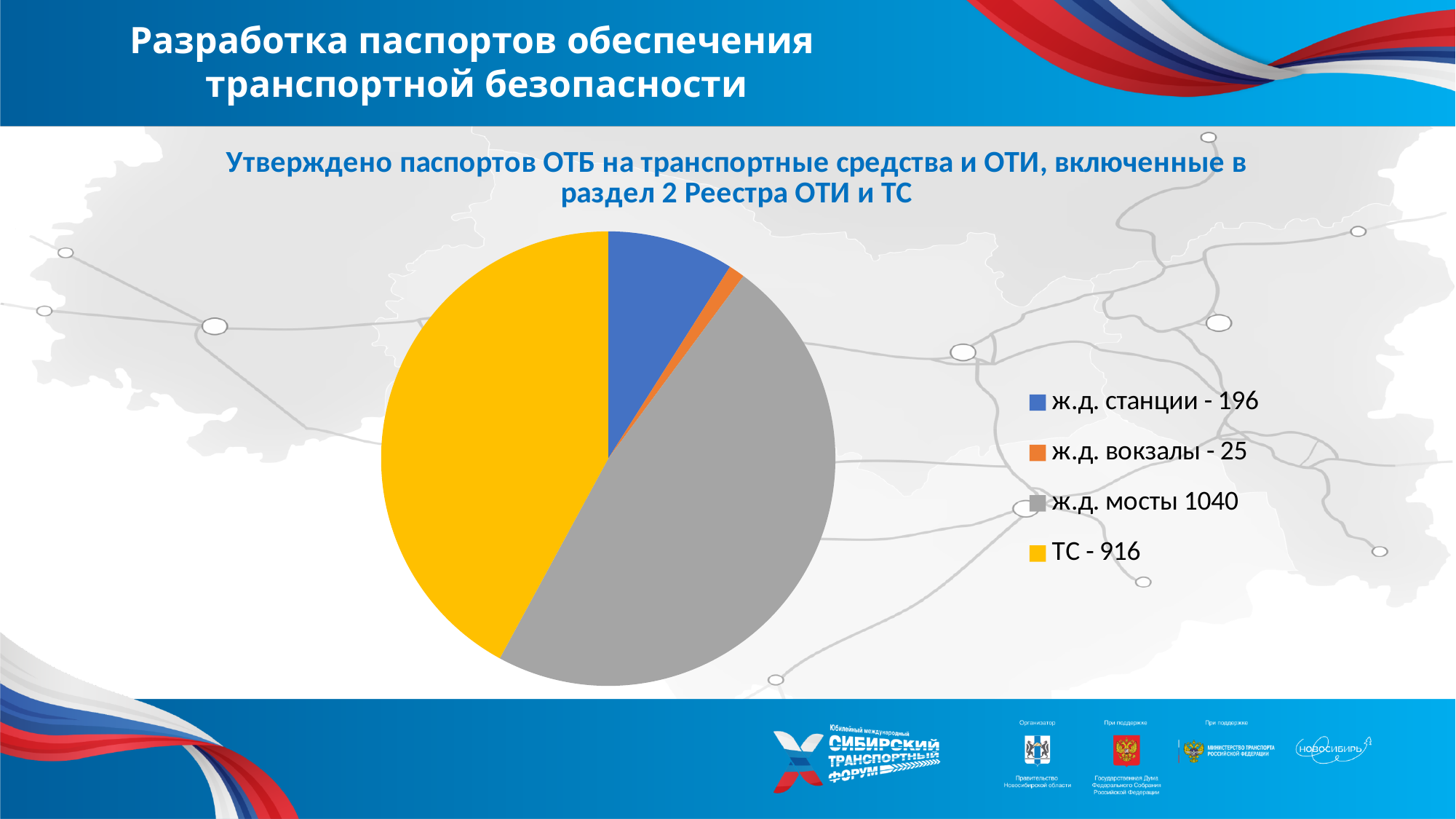
What value is shown for ж.д. вокзалы in the pie chart? 25 What is the difference between the values for ж.д. станции and ж.д. вокзалы? 171 Which is larger, the value for ТС or the value for ж.д. станции? ТС What colour is the ТС slice in the pie chart? yellow What is the difference between the values for ж.д. мосты and ТС? 124 What value is shown for ж.д. мосты in the pie chart? 1040 What value is shown for ТС in the pie chart? 916 What value is shown for ж.д. станции in the pie chart? 196 What kind of chart is shown on the slide? pie chart Which category has the largest value in the pie chart? ж.д. мосты How many categories does the pie chart show? 4 Which category has the smallest value in the pie chart? ж.д. вокзалы